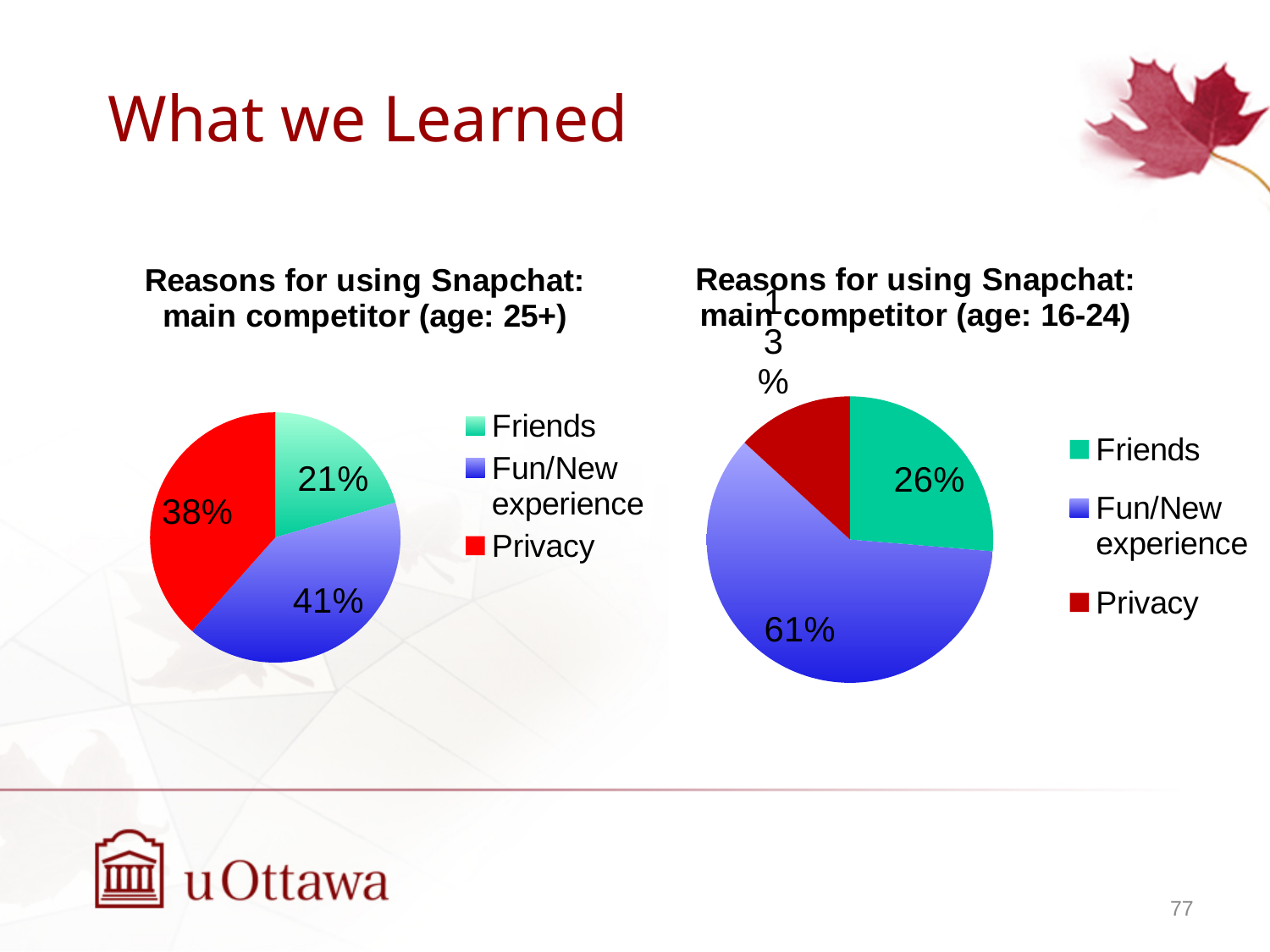
In the 'Reasons for using Snapchat: main competitor (age: 16-24)' chart, which reason has the smallest share? Privacy In the 'Reasons for using Snapchat: main competitor (age: 16-24)' chart, what percentage is shown for Friends? 26% How many categories does the legend of the 'Reasons for using Snapchat: main competitor (age: 25+)' chart list? 3 In the 'Reasons for using Snapchat: main competitor (age: 25+)' chart, which reason has the largest share? Fun/New experience In the 'Reasons for using Snapchat: main competitor (age: 25+)' chart, what percentage is shown for Friends? 21% In the 'Reasons for using Snapchat: main competitor (age: 16-24)' chart, what percentage is shown for Fun/New experience? 61% In the 'Reasons for using Snapchat: main competitor (age: 16-24)' chart, what is the difference between the Fun/New experience share and the Friends share? 35% In the 'Reasons for using Snapchat: main competitor (age: 25+)' chart, what percentage is shown for Privacy? 38% What type of chart is used for 'Reasons for using Snapchat: main competitor (age: 16-24)'? Pie chart In the 'Reasons for using Snapchat: main competitor (age: 25+)' chart, which reason has the smallest share? Friends Which chart shows a larger share for Privacy: the age 25+ chart or the age 16-24 chart? The age 25+ chart In the 'Reasons for using Snapchat: main competitor (age: 25+)' chart, what is the difference between the Fun/New experience share and the Friends share? 20%